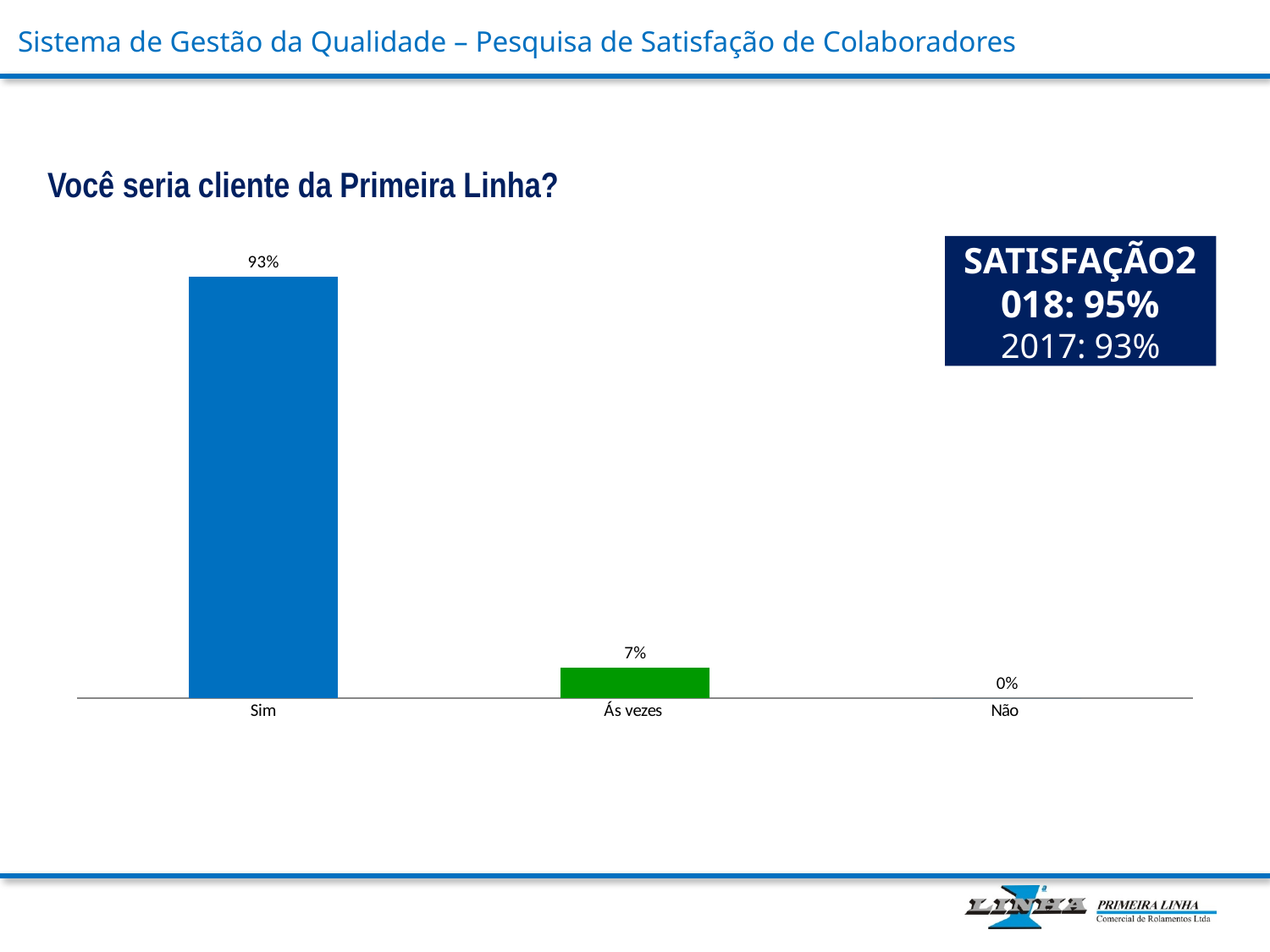
Which category has the lowest value? Não What is the value for "Não"? 0% How many categories are shown on the x axis? 3 Which category has the highest value? Sim Do the values rise or fall from left to right along the x axis? Fall What question does the chart on the slide answer? Você seria cliente da Primeira Linha? What is the value for "Ás vezes"? 7% Which is larger, the value for "Ás vezes" or the value for "Não"? Ás vezes What colour is the bar for "Ás vezes"? Green What kind of chart is shown on the slide? Bar chart What is the difference between the values for "Sim" and "Ás vezes"? 86% What is the value for "Sim"? 93%